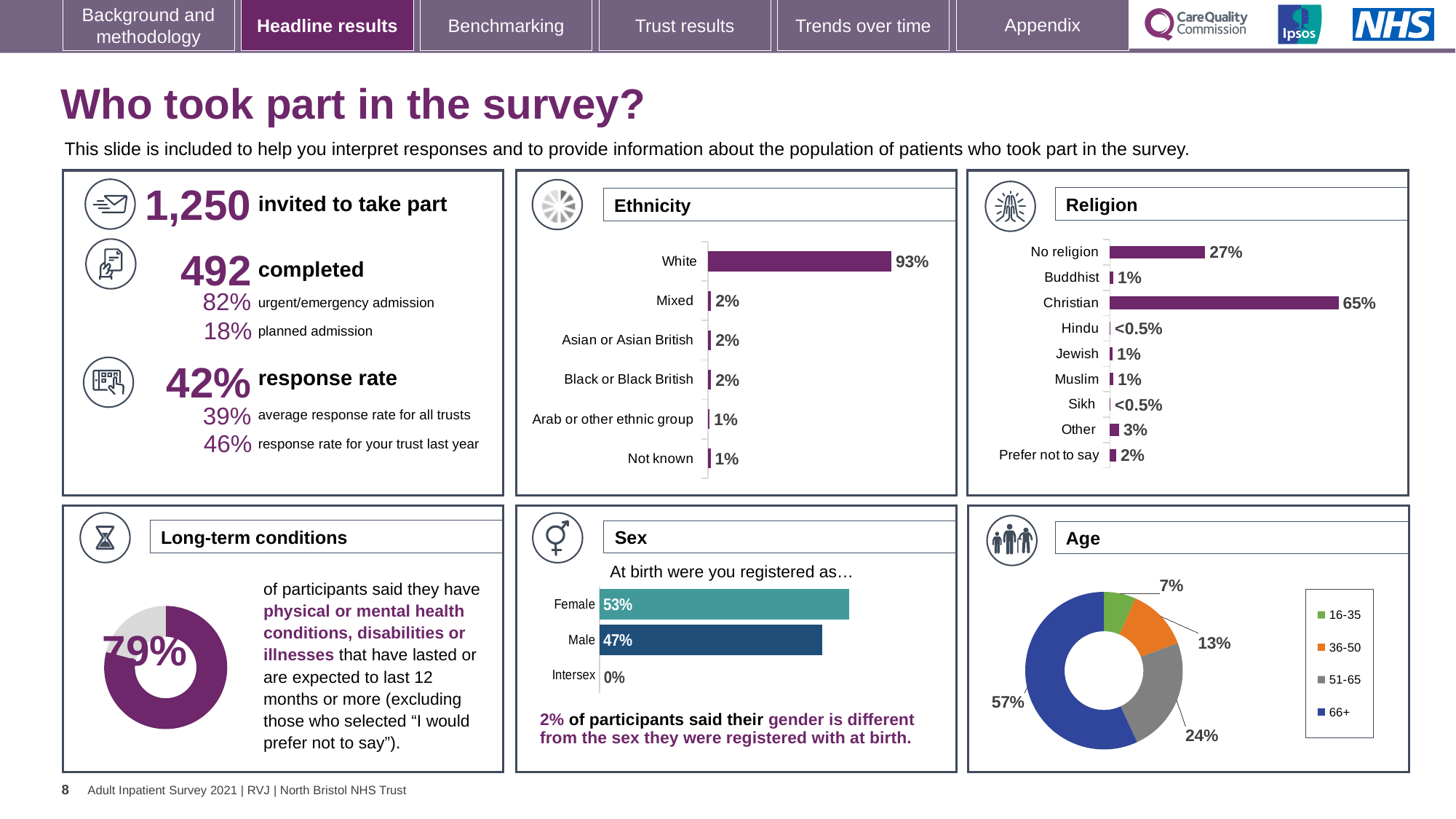
In the Religion chart, what percentage of participants were Christian? 65% How many age groups does the legend of the Age chart list? 4 How many ethnic group categories are shown in the Ethnicity chart? 6 In the Religion chart, what is the difference between the Christian and No religion percentages? 38% How many religion categories are shown in the Religion chart? 9 In the Age chart, what share of participants were aged 66+? 57% In the Ethnicity chart, which ethnic group has the highest percentage? White In the Sex chart, what is the difference between the Female and Male percentages? 6% In the Ethnicity chart, what percentage of participants were White? 93% In the Sex chart, what percentage of participants were registered as Female at birth? 53% In the Religion chart, which is larger, the value for Other or the value for Prefer not to say? Other What kind of chart is the Age chart? Donut (pie) chart